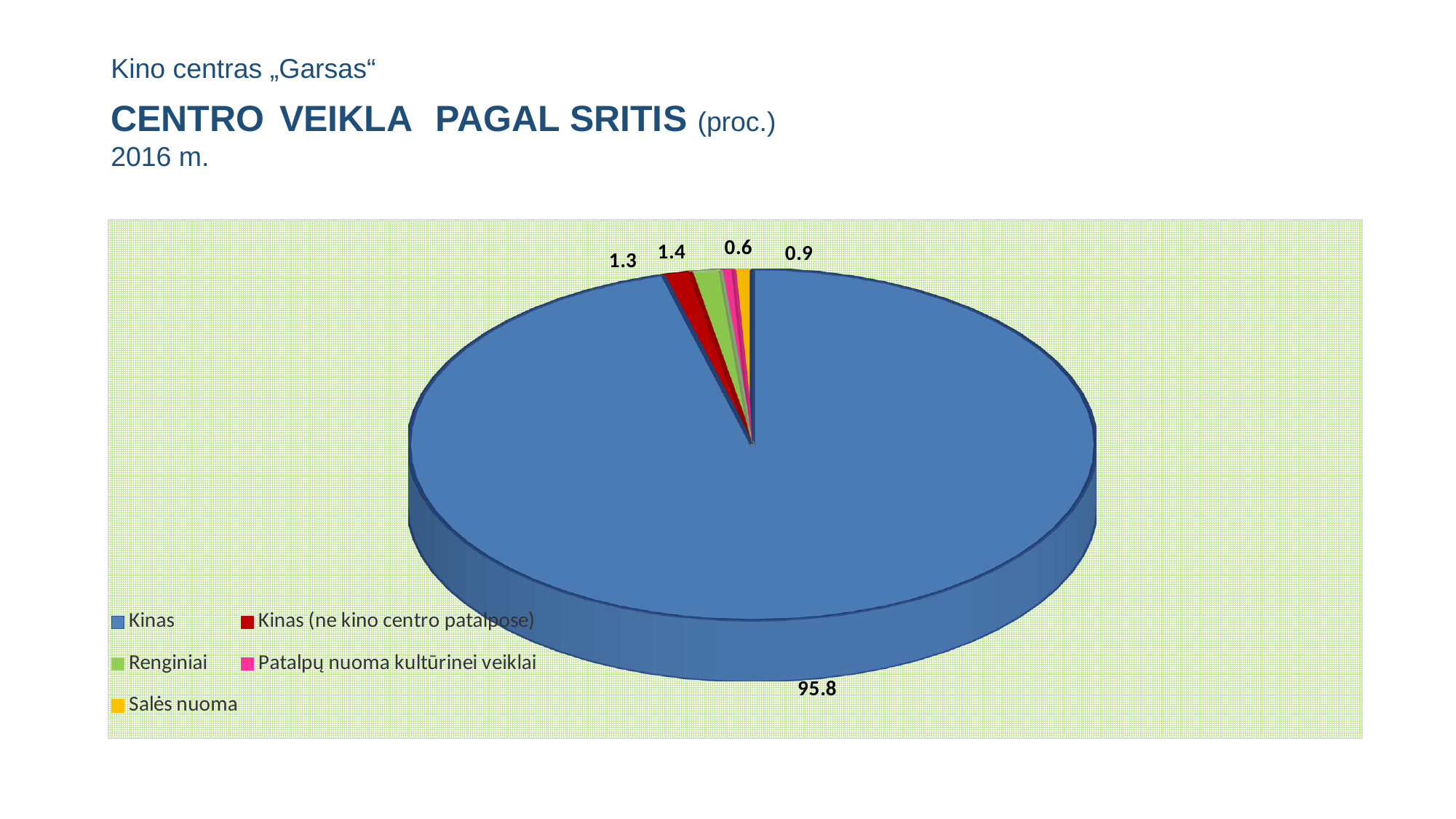
Which category has the largest share of the pie? Kinas What is the value for Kinas? 95.8 Which category has the smallest share of the pie? Patalpų nuoma kultūrinei veiklai What is the value for Salės nuoma? 0.9 What is the value for Kinas (ne kino centro patalpose)? 1.3 What kind of chart is shown on the slide? pie chart Which is larger, the value for Salės nuoma or the value for Patalpų nuoma kultūrinei veiklai? Salės nuoma What is the value for Patalpų nuoma kultūrinei veiklai? 0.6 What is the difference between the values for Kinas and Renginiai? 94.4 What colour is the slice for Kinas? blue How many categories does the pie chart have? 5 What is the value for Renginiai? 1.4